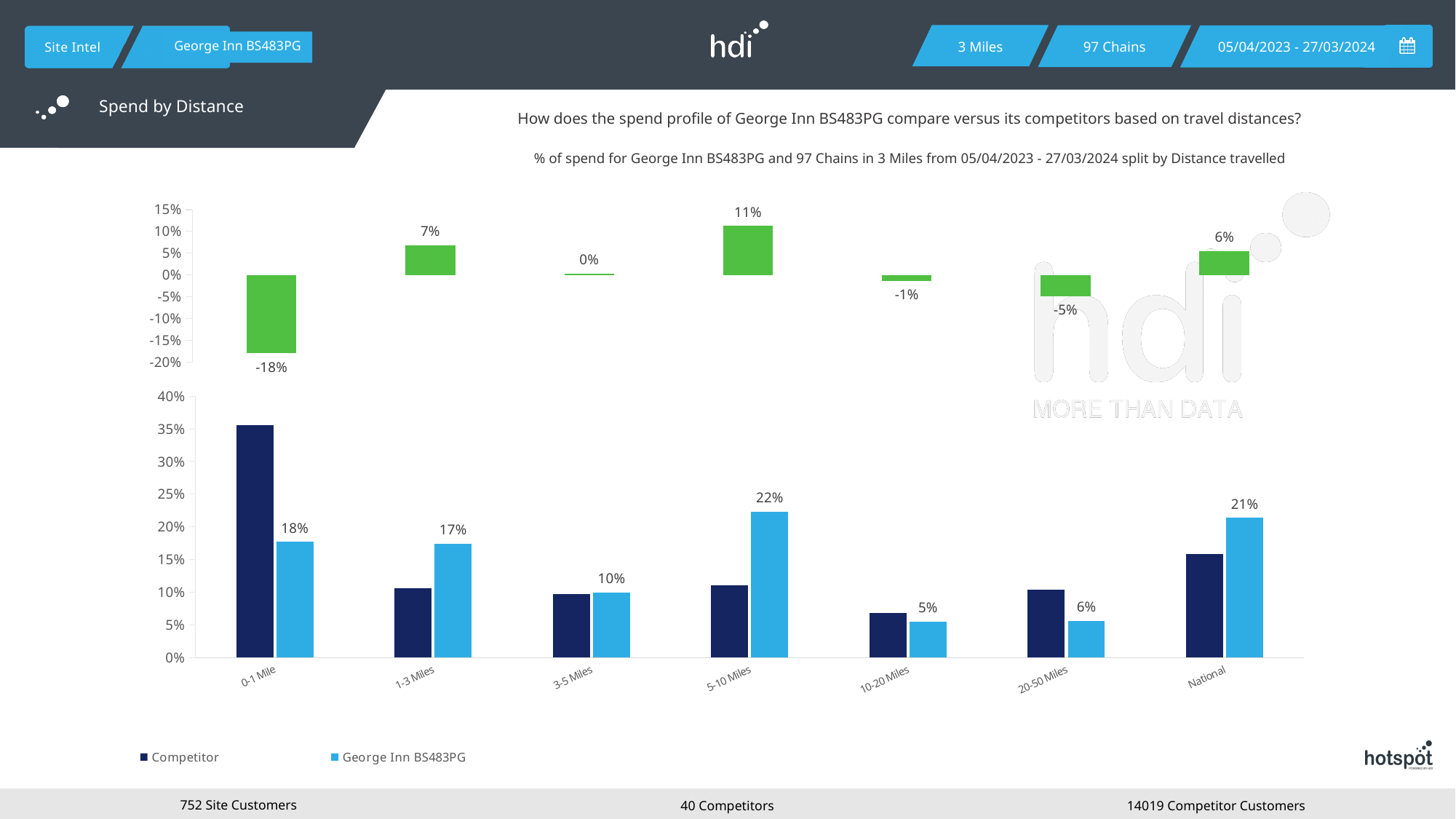
In the top chart, what is the value for 0-1 Mile? -18% In the bottom chart, how many series does the legend list? 2 In the bottom chart, what is the value for George Inn BS483PG at National? 21% In the bottom chart, what is the difference between the George Inn BS483PG values for 5-10 Miles and 10-20 Miles? 17 percentage points In the bottom chart, which distance band has the highest George Inn BS483PG value? 5-10 Miles In the bottom chart, is the Competitor value for 0-1 Mile greater or less than 30%? greater In the bottom chart, at 0-1 Mile, which is larger: the Competitor bar or the George Inn BS483PG bar? Competitor In the bottom chart, how many distance categories are shown on the x axis? 7 In the bottom chart, which distance band has the lowest George Inn BS483PG value? 10-20 Miles In the top chart, which distance band has the highest value? 5-10 Miles What kind of chart is the bottom chart? bar chart In the bottom chart, what is the value for George Inn BS483PG at 5-10 Miles? 22%